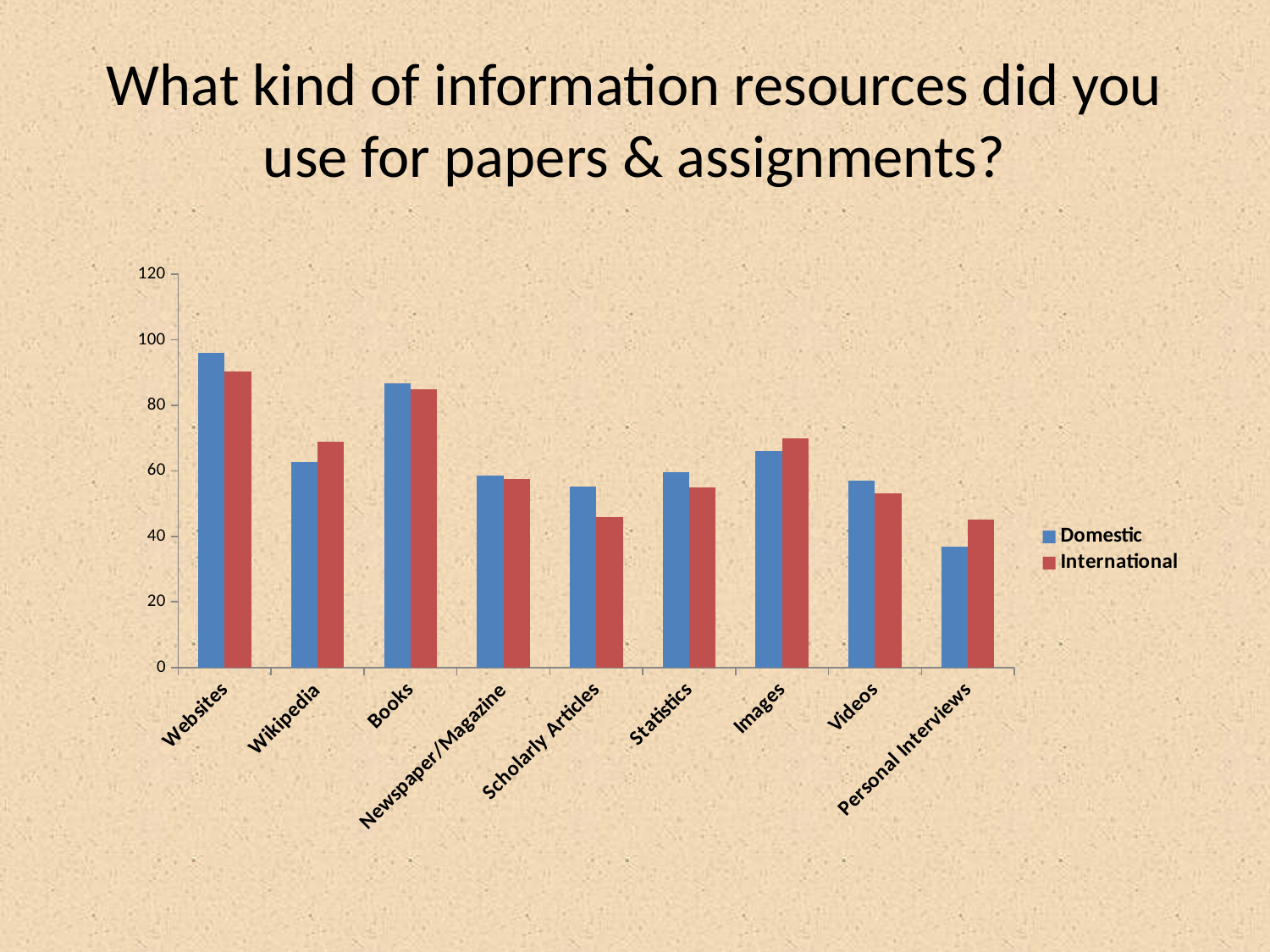
Is the International value for Images greater or less than 60? greater What kind of chart is shown on the slide? bar chart What are the two series named in the legend? Domestic and International Is the Domestic value for Personal Interviews greater or less than 40? less For Scholarly Articles, which is larger, the Domestic or the International value? Domestic Which category has the highest Domestic value? Websites How many series does the legend list? 2 Which category has the highest International value? Websites Is the Domestic value for Websites greater or less than 80? greater For Wikipedia, which is larger, the Domestic or the International value? International How many information resource categories are shown on the x axis? 9 Which category has the lowest Domestic value? Personal Interviews